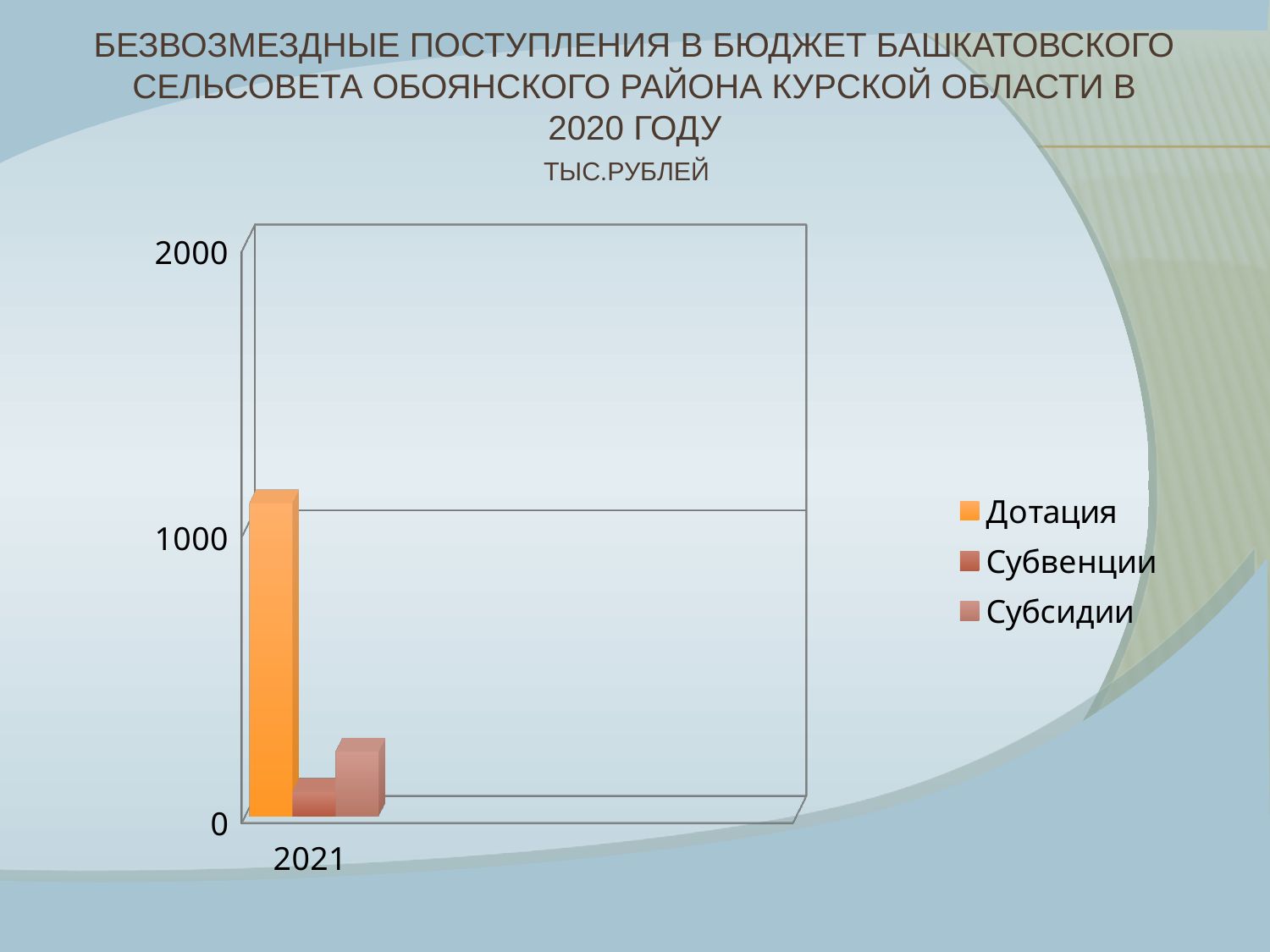
How many series does the legend list? 3 Is the value for Субсидии in 2021 greater or less than 1000? less Is the value for Дотация in 2021 greater or less than 1000? greater Which is larger for 2021, Субсидии or Субвенции? Субсидии Which series has the lowest value for 2021? Субвенции Which series has the highest value for 2021? Дотация Is the value for Дотация in 2021 greater or less than 2000? less What category label is shown on the x axis? 2021 How many categories are shown on the x axis? 1 What unit is stated below the chart title? ТЫС.РУБЛЕЙ What kind of chart is shown on the slide? bar chart Which is larger for 2021, Дотация or Субсидии? Дотация